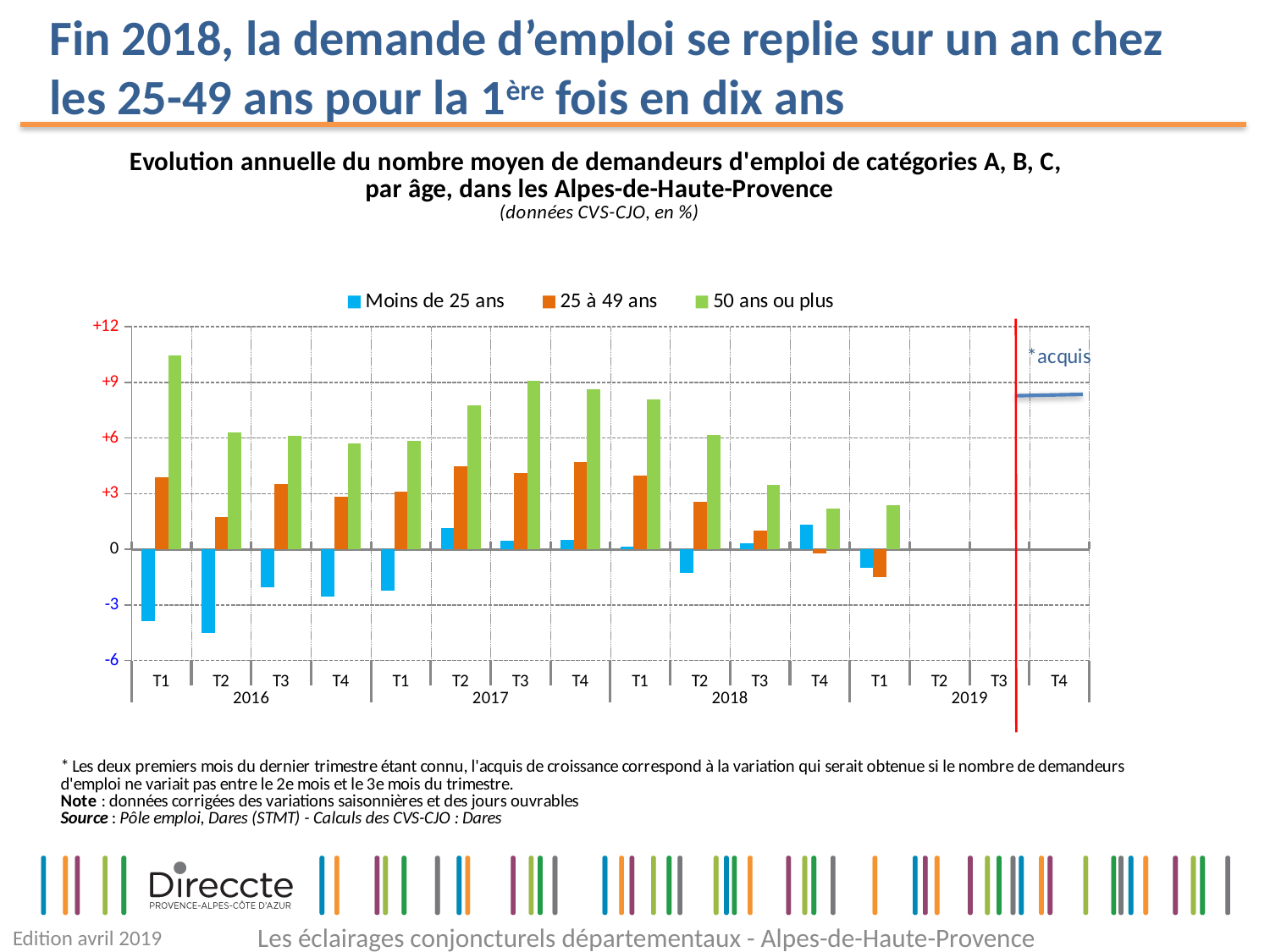
Is the value for 'Moins de 25 ans' in T2 2016 greater or less than -3? less How many series does the legend list? 3 How many years are labelled on the x axis? 4 In which quarter is the bar for 'Moins de 25 ans' the lowest? T2 2016 Do the values for '50 ans ou plus' rise or fall from T1 2018 to T4 2018? fall In which quarter is the bar for '50 ans ou plus' the highest? T1 2016 Is the value for '50 ans ou plus' in T3 2018 greater or less than +6? less Is the value for '25 à 49 ans' in T4 2017 greater or less than +3? greater In T1 2019, which is larger: the value for '50 ans ou plus' or the value for '25 à 49 ans'? 50 ans ou plus Which age groups are listed in the legend? Moins de 25 ans, 25 à 49 ans, 50 ans ou plus What kind of chart is shown on the slide? bar chart